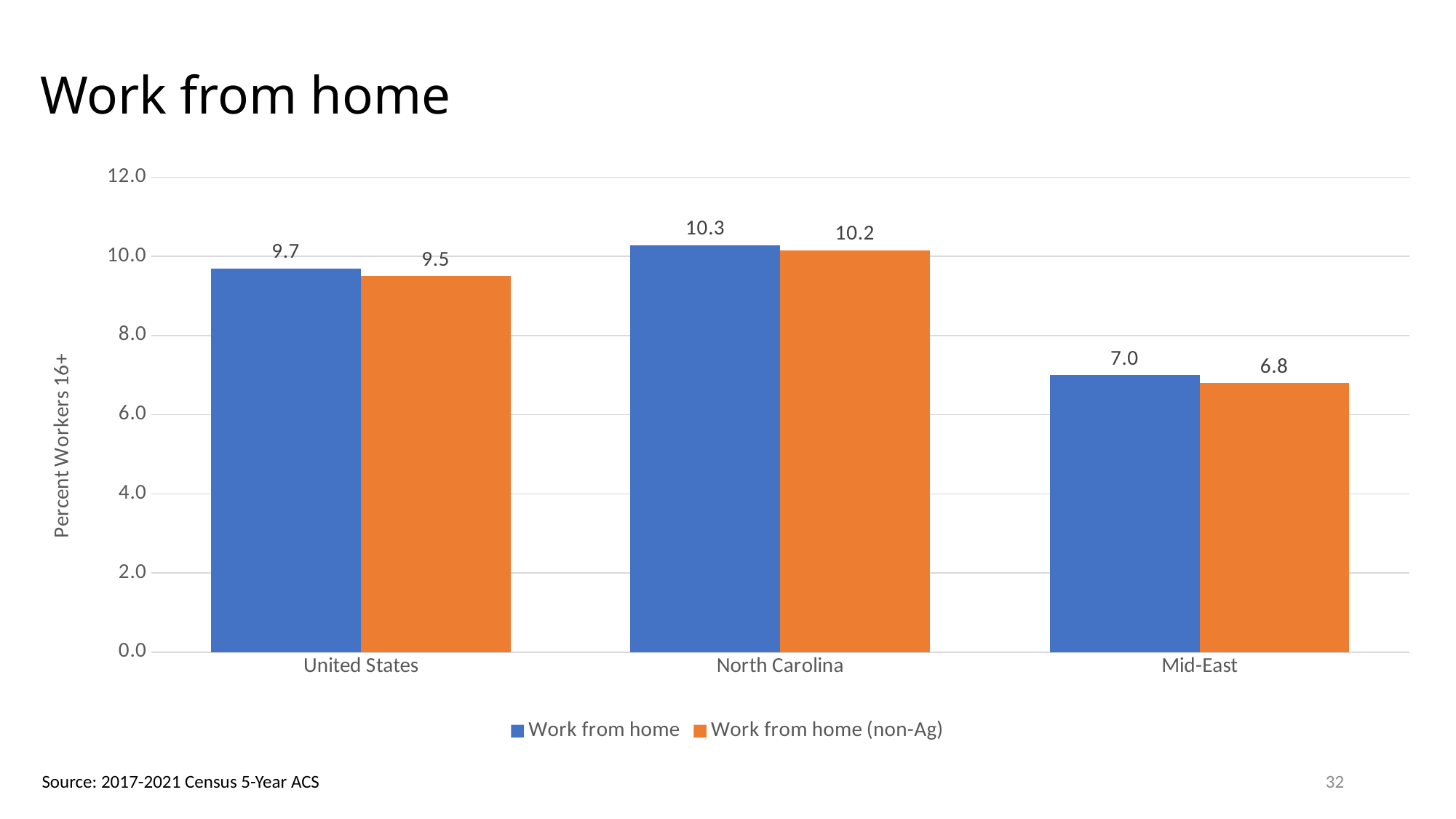
Which region has the lowest 'Work from home (non-Ag)' value? Mid-East What is the difference between the 'Work from home' and 'Work from home (non-Ag)' values for the United States? 0.2 Which region has the highest 'Work from home' value? North Carolina What is the 'Work from home' value for Mid-East? 7.0 Is the 'Work from home (non-Ag)' value for North Carolina greater or less than 8.0? greater What kind of chart is shown on the slide? Bar chart How many series does the legend list? 2 What is the 'Work from home (non-Ag)' value for the United States? 9.5 What is the difference between the 'Work from home' values for North Carolina and Mid-East? 3.3 Which is larger: the 'Work from home' value for the United States or for Mid-East? United States What is the 'Work from home' value for North Carolina? 10.3 How many regions are shown on the x axis? 3